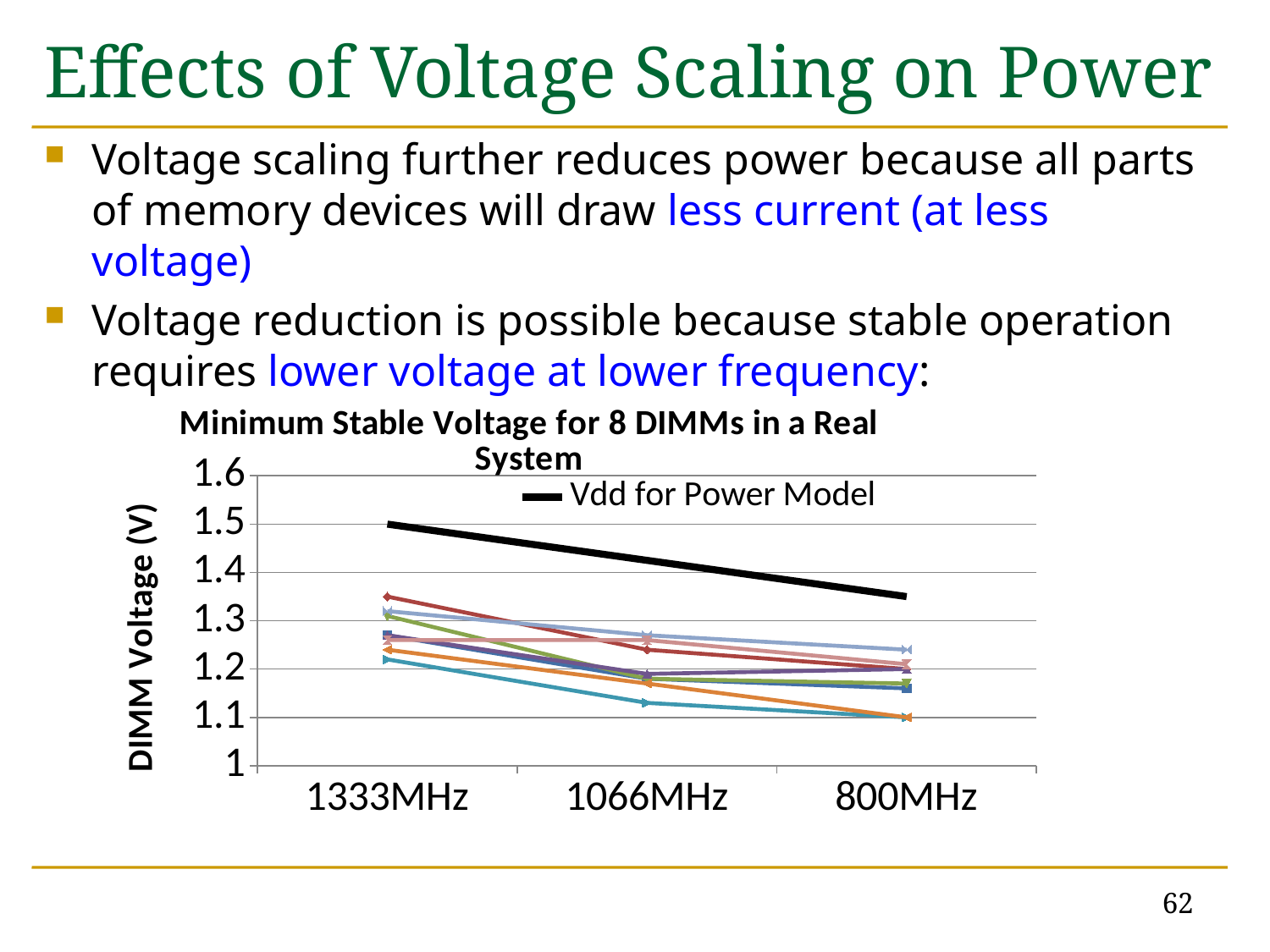
Is the value of the Vdd for Power Model line at 800MHz greater or less than 1.3? greater Is the value of the Vdd for Power Model line at 800MHz greater or less than 1.4? less How many frequency categories are shown on the x-axis? 3 What is the title of the chart? Minimum Stable Voltage for 8 DIMMs in a Real System What is the label of the y-axis of the chart? DIMM Voltage (V) Does the Vdd for Power Model line rise or fall from 1333MHz to 800MHz? fall What type of chart is shown on the slide? Line chart What is the value of the Vdd for Power Model line at 1333MHz? 1.5 Is the value of the Vdd for Power Model line at 1066MHz greater or less than 1.3? greater How many series does the chart legend list? 1 Is the Vdd for Power Model line above or below all the other plotted lines? above At which frequency is the Vdd for Power Model value highest? 1333MHz